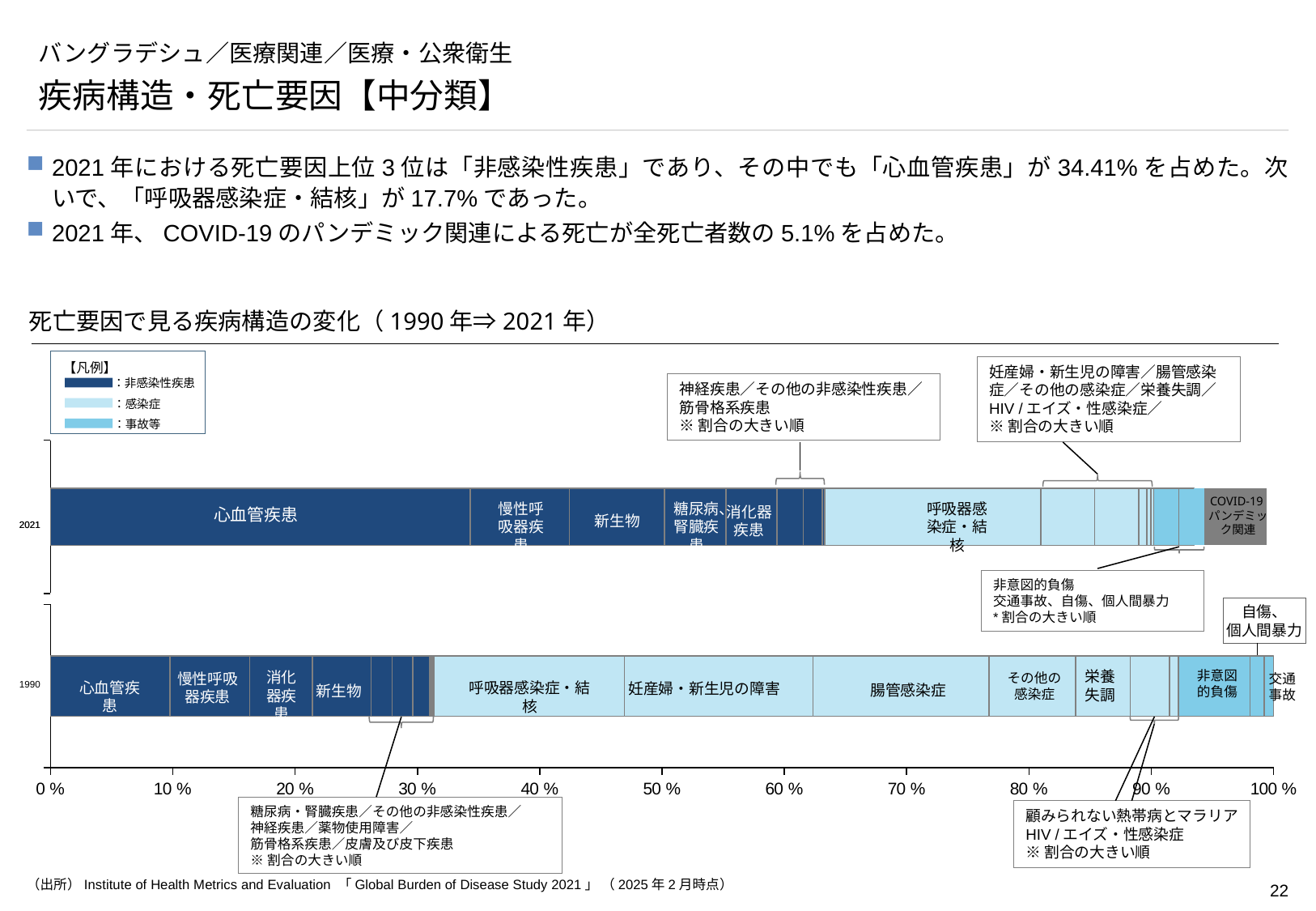
Which cause of death has the largest share in the 2021 bar? 心血管疾患 Which two years are compared in the chart? 1990 and 2021 According to the slide, what share of deaths did 呼吸器感染症・結核 account for in 2021? 17.7% Which year has the larger share for 心血管疾患, 1990 or 2021? 2021 What kind of chart is shown on the slide? Stacked horizontal bar chart Did the combined share of 非感染性疾患 (dark blue) rise or fall from 1990 to 2021? Rise How many categories does the legend (凡例) list? 3 According to the slide, what share of all deaths in 2021 was related to the COVID-19 pandemic? 5.1% What is the maximum value shown on the horizontal axis? 100 % According to the slide, what share of deaths did 心血管疾患 account for in 2021? 34.41% Is the share of 心血管疾患 in the 2021 bar greater or less than 30%? greater